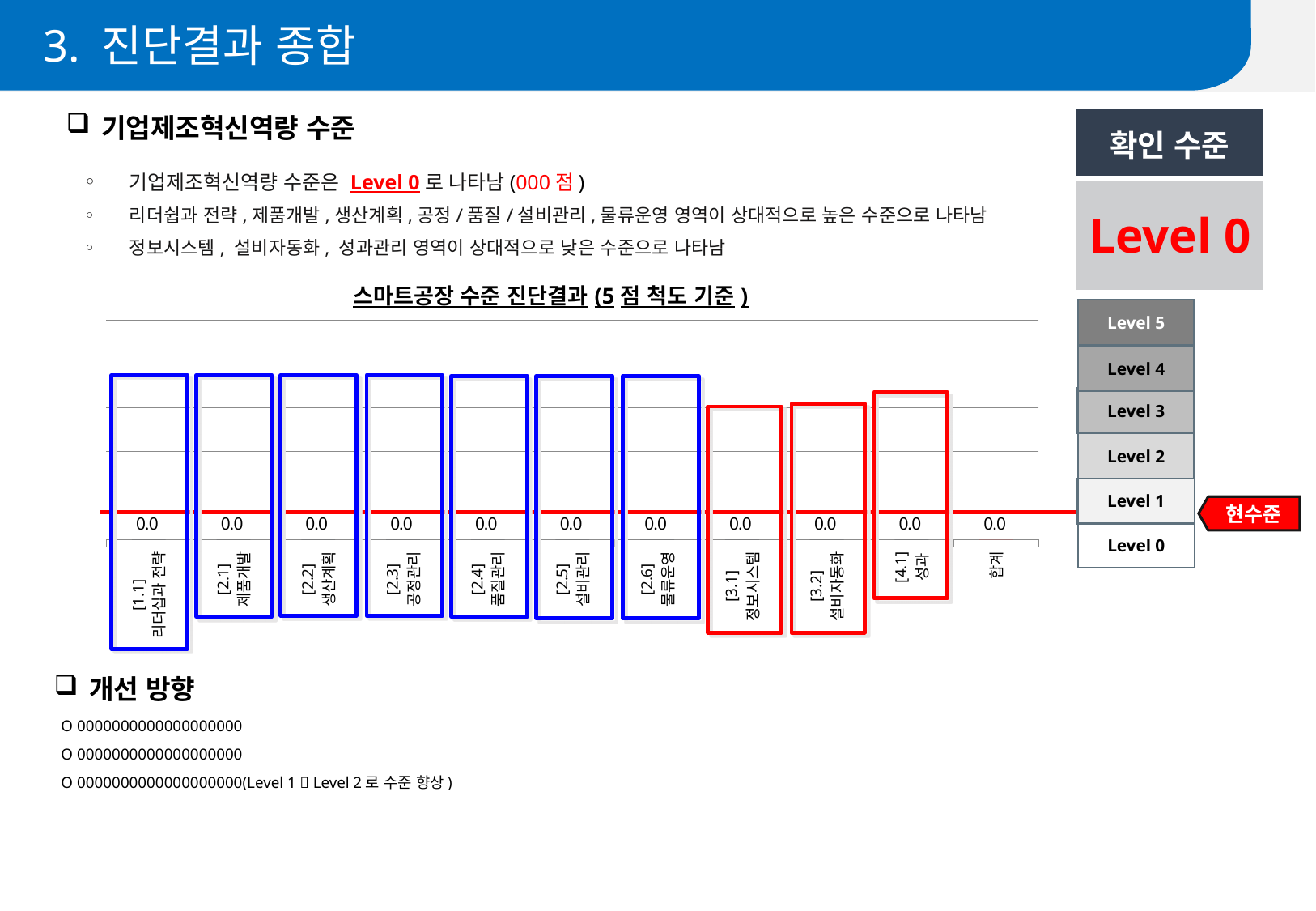
Which category label appears last (rightmost) on the x axis of the chart? 합계 What is the title of the chart? 스마트공장 수준 진단결과 (5 점 척도 기준 ) What is the value for [2.4] 품질관리 in the chart? 0.0 What is the value for [4.1] 성과 in the chart? 0.0 What is the value for 합계 in the chart? 0.0 What is the value for [1.1] 리더십과 전략 in the chart? 0.0 What is the difference between the values for [2.1] 제품개발 and [3.2] 설비자동화? 0.0 What kind of chart is shown on the slide? Bar chart What is the value for [3.1] 정보시스템 in the chart? 0.0 How many categories are shown on the x axis of the chart? 11